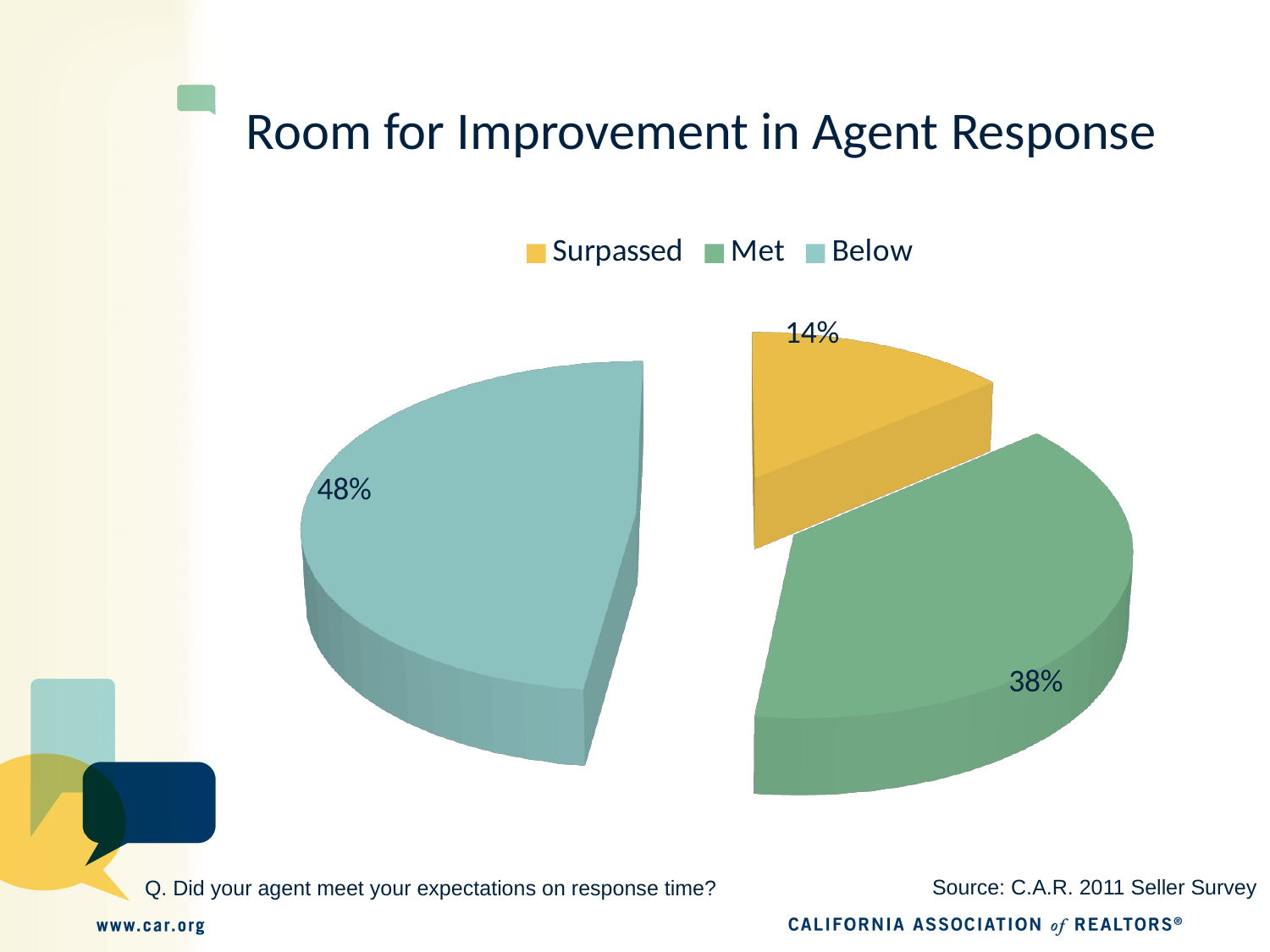
What colour is the Below slice in the pie chart? Light teal How many categories are shown in the pie chart? 3 What is the difference in percentage points between the Below and Met slices? 10 What percentage of sellers said their agent was below expectations on response time? 48% What is the difference in percentage points between the Met and Surpassed slices? 24 What percentage of sellers said their agent met expectations on response time? 38% Which is larger, the Met slice or the Surpassed slice? Met What percentage of sellers said their agent surpassed expectations on response time? 14% Which category has the smallest share of the pie? Surpassed Which category has the largest share of the pie? Below What is the title of the chart on the slide? Room for Improvement in Agent Response What kind of chart is shown on the slide? Pie chart